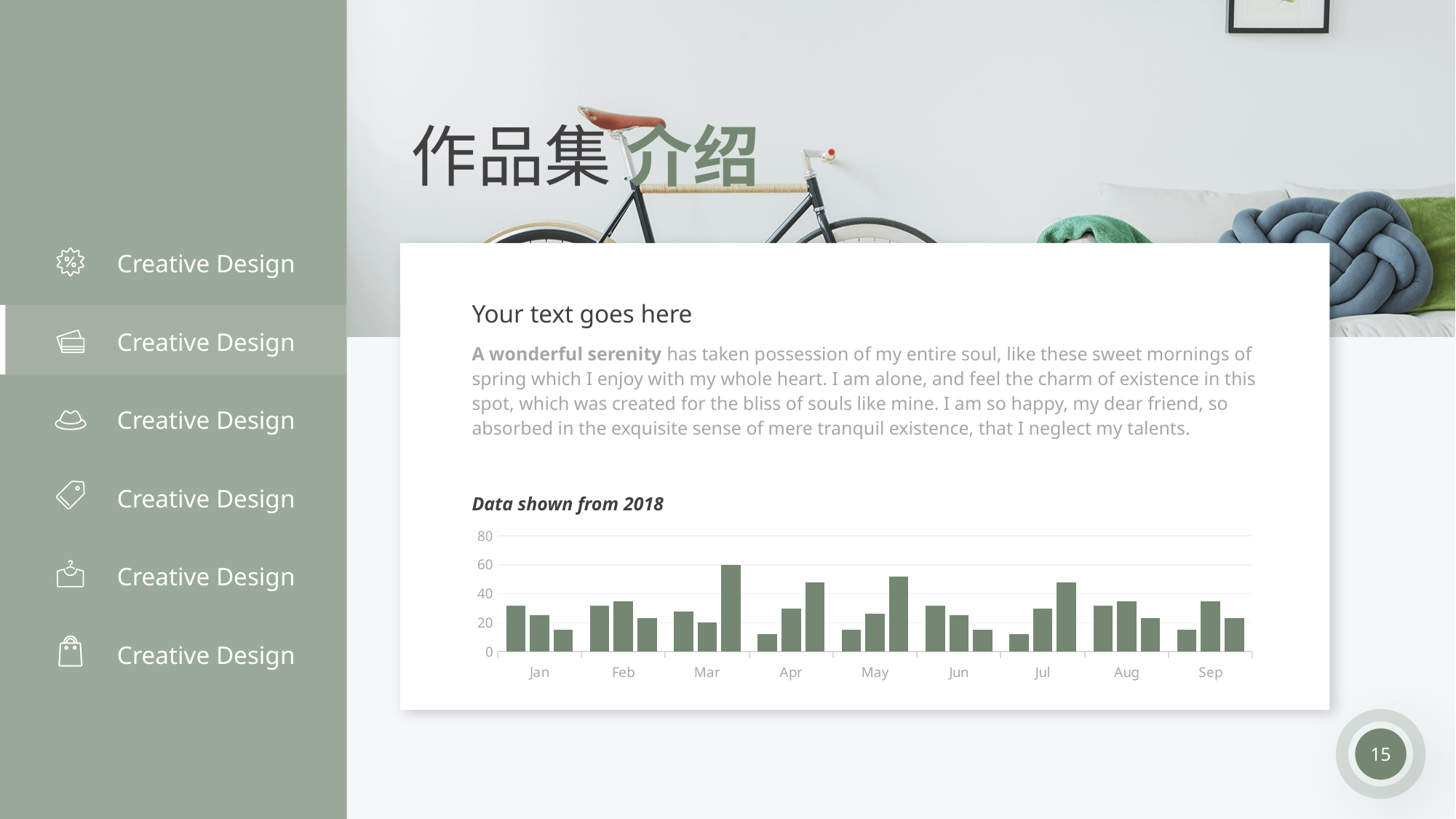
Is the shortest bar for Jan greater or less than 20? less How many bars are plotted for each month in the chart? 3 What kind of chart is shown on the slide? bar chart Is the tallest bar for May greater or less than 40? greater Which month contains the tallest bar in the chart? Mar Which is taller: the tallest bar for Mar or the tallest bar for Jun? Mar Is the tallest bar for Mar greater or less than 40? greater What is the title of the chart? Data shown from 2018 How many months are shown on the x axis of the chart? 9